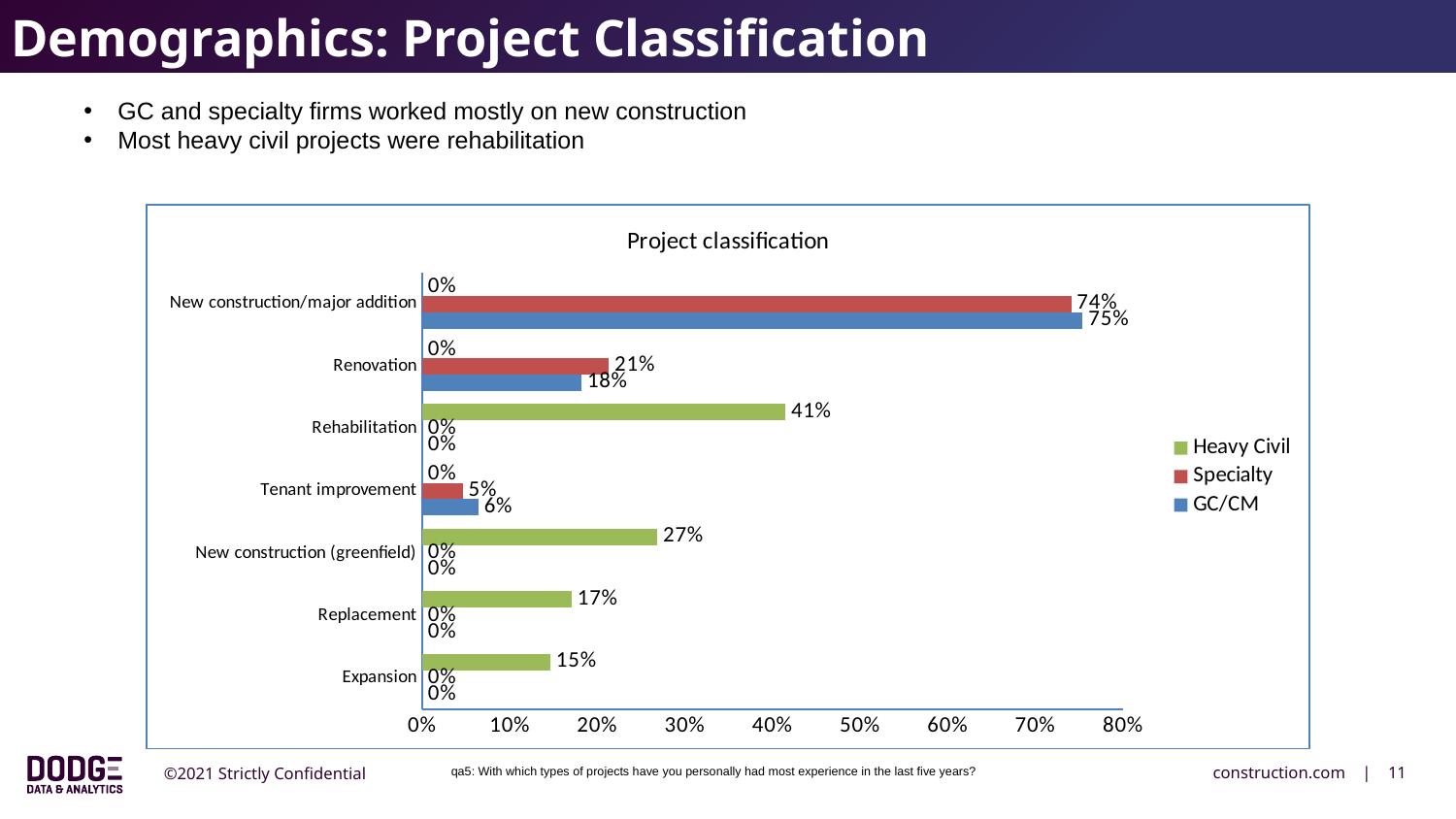
What is the difference between the Specialty and GC/CM values for Renovation? 3% What is the Heavy Civil value for Expansion? 15% How many series does the legend list? 3 Which series is shown in green in the legend? Heavy Civil What is the difference between the Heavy Civil values for New construction (greenfield) and Replacement? 10% What is the GC/CM value for New construction/major addition? 75% What is the Heavy Civil value for Rehabilitation? 41% Which category has the highest Heavy Civil value? Rehabilitation Which is larger for Tenant improvement, the Specialty value or the GC/CM value? GC/CM What is the Specialty value for Renovation? 21% What type of chart is shown on the slide? bar chart How many project classification categories are shown on the chart? 7